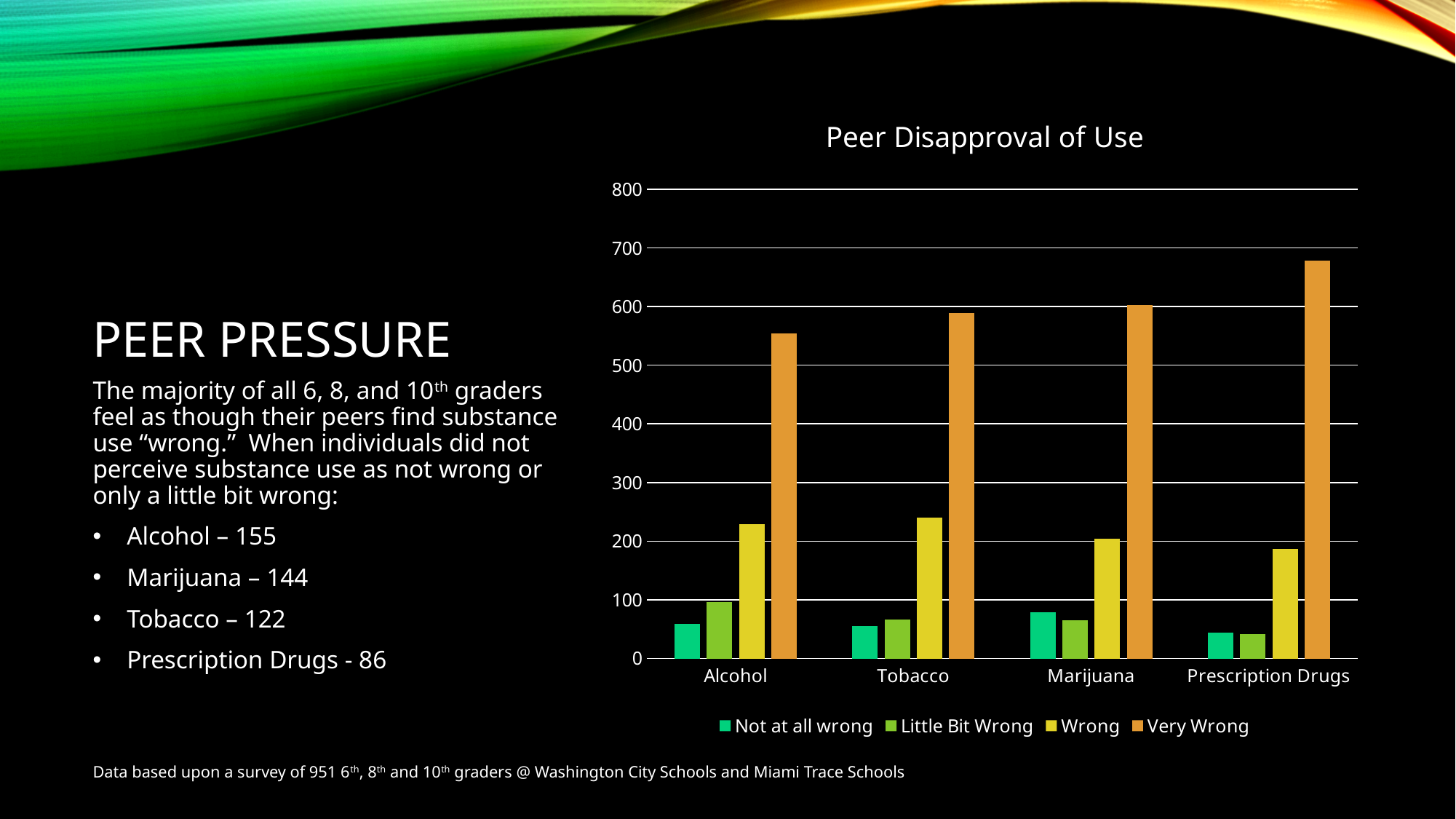
Which substance has the highest 'Very Wrong' value? Prescription Drugs Is the 'Very Wrong' value for Prescription Drugs greater or less than 600? greater Is the 'Very Wrong' value for Alcohol greater or less than 600? less What kind of chart is shown on the slide? Bar chart Is the 'Little Bit Wrong' value for Prescription Drugs greater or less than 100? less How many series does the legend of the chart list? 4 Which is larger: the 'Not at all wrong' value for Marijuana or for Alcohol? Marijuana How many substance categories are shown on the x axis of the chart? 4 Which substance has the lowest 'Very Wrong' value? Alcohol Which is larger: the 'Wrong' value for Alcohol or the 'Wrong' value for Prescription Drugs? Alcohol What is the title of the chart? Peer Disapproval of Use